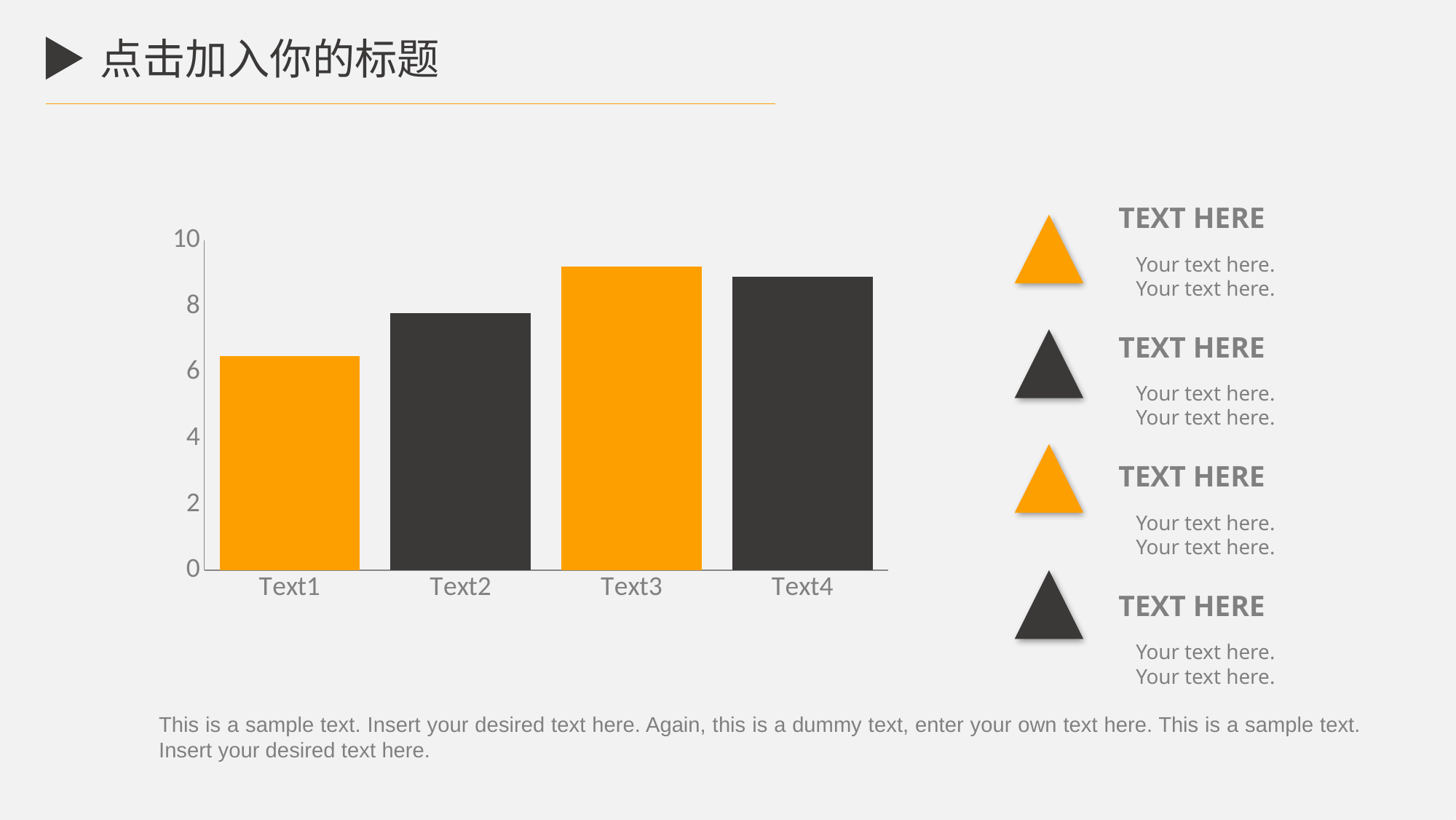
Which category has the lowest bar in the chart? Text1 How many categories are shown on the x axis of the chart? 4 Is the value for Text4 greater or less than 8? greater Is the value for Text1 greater or less than 8? less Is the value for Text1 greater or less than 6? greater What colour is the bar for Text1? orange What kind of chart is shown on the slide? bar chart Which category has the highest bar in the chart? Text3 Which is larger, the value for Text3 or the value for Text1? Text3 Which is larger, the value for Text1 or the value for Text2? Text2